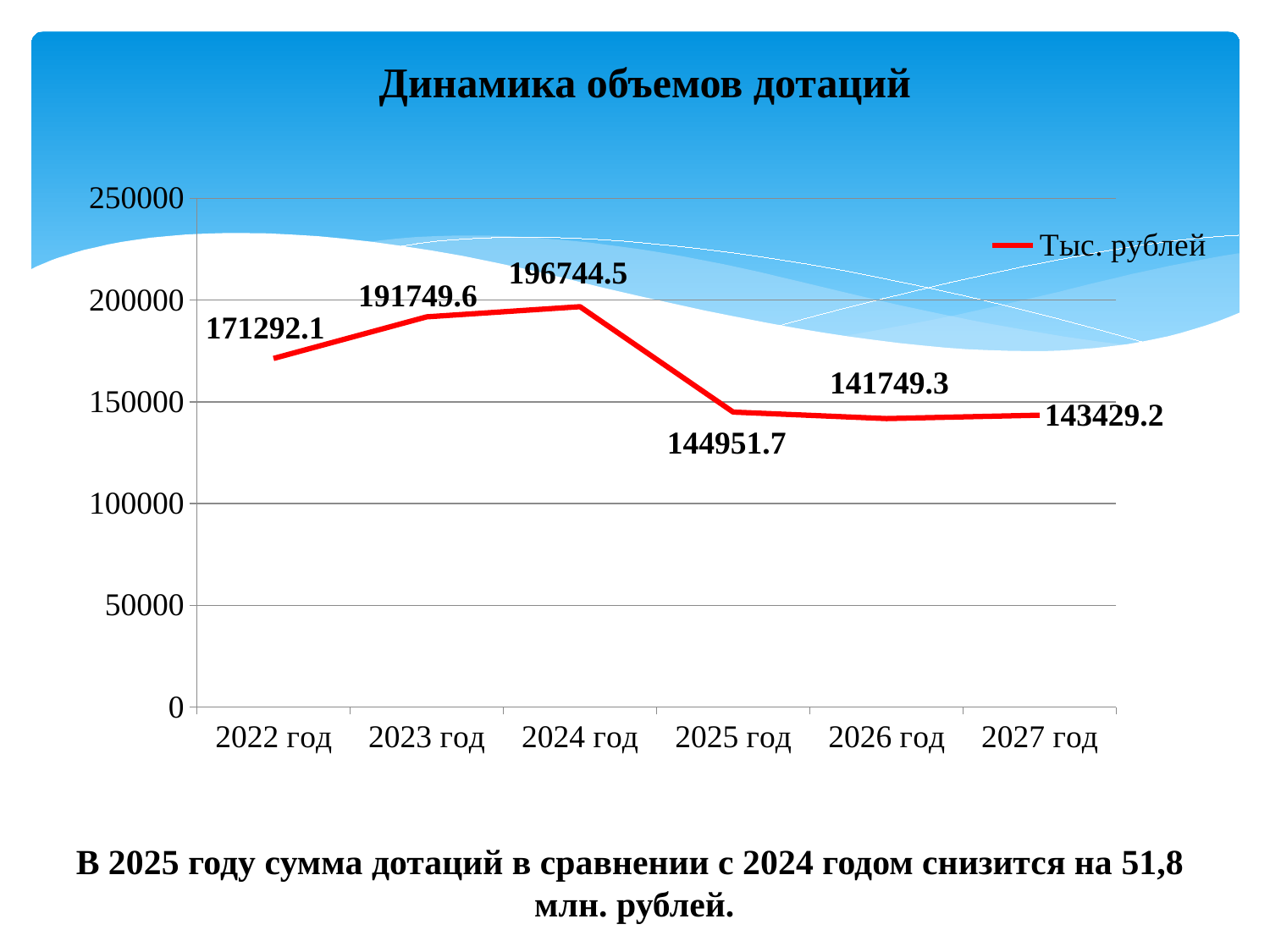
What is the value for 2024 год? 196744.5 Which is larger, the value for 2023 год or the value for 2025 год? 2023 год What type of chart is shown on the slide? line chart What is the title of the chart? Динамика объемов дотаций What is the value for 2027 год? 143429.2 What is the difference between the values for 2024 год and 2025 год? 51792.8 What is the value for 2022 год? 171292.1 How many years are plotted on the x axis? 6 What series name does the legend show? Тыс. рублей Is the value for 2026 год greater or less than 150000? less Which year has the highest value? 2024 год Which year has the lowest value? 2026 год